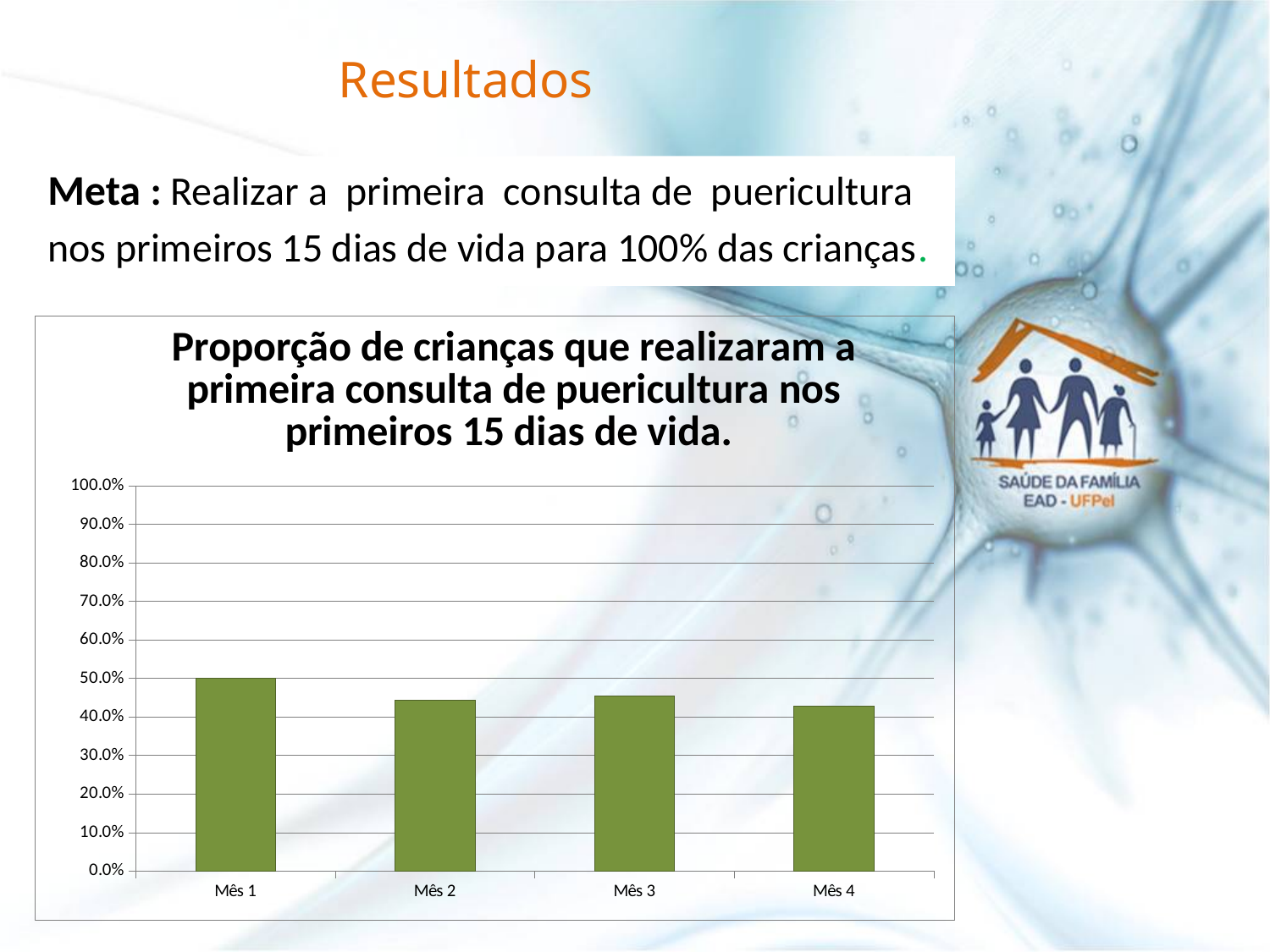
Is the value for Mês 2 greater or less than 50.0%? less What is the highest value shown on the vertical axis of the chart? 100.0% Which month has the highest proportion of children who had their first childcare consultation in the first 15 days of life? Mês 1 Which is larger, the value for Mês 1 or the value for Mês 4? Mês 1 What kind of chart is shown on the slide? bar chart What colour are the bars in the chart? green What is the title of the chart? Proporção de crianças que realizaram a primeira consulta de puericultura nos primeiros 15 dias de vida. Is the value for Mês 4 greater or less than 50.0%? less Is the value for Mês 3 greater or less than 40.0%? greater How many months (categories) are plotted on the chart? 4 Which is larger, the value for Mês 1 or the value for Mês 3? Mês 1